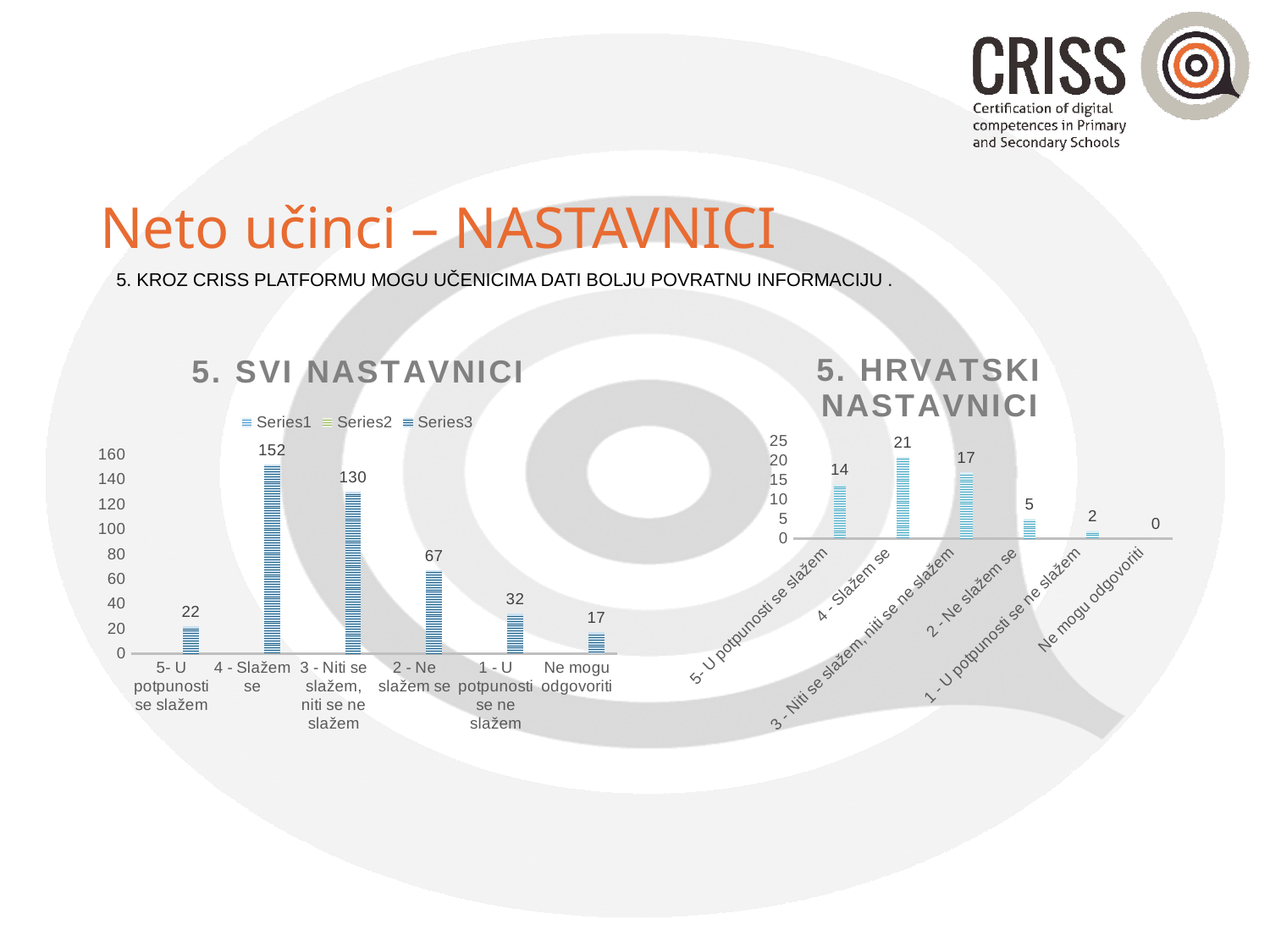
In the '5. HRVATSKI NASTAVNICI' chart, what is the value for '5 - U potpunosti se slažem'? 14 In the '5. HRVATSKI NASTAVNICI' chart, what is the value for 'Ne mogu odgovoriti'? 0 In the '5. SVI NASTAVNICI' chart, how many series does the legend list? 3 In the '5. SVI NASTAVNICI' chart, which category has the highest value? 4 - Slažem se In the '5. SVI NASTAVNICI' chart, what is the value for '2 - Ne slažem se'? 67 In the '5. SVI NASTAVNICI' chart, which category has the lowest value? Ne mogu odgovoriti In the '5. HRVATSKI NASTAVNICI' chart, which is larger: the value for '3 - Niti se slažem, niti se ne slažem' or the value for '2 - Ne slažem se'? 3 - Niti se slažem, niti se ne slažem What kind of chart is the '5. SVI NASTAVNICI' chart? Bar chart In the '5. SVI NASTAVNICI' chart, what is the value for '4 - Slažem se'? 152 How many categories are shown in the '5. HRVATSKI NASTAVNICI' chart? 6 In the '5. HRVATSKI NASTAVNICI' chart, which category has the highest value? 4 - Slažem se In the '5. SVI NASTAVNICI' chart, what is the difference between the values for '4 - Slažem se' and '3 - Niti se slažem, niti se ne slažem'? 22